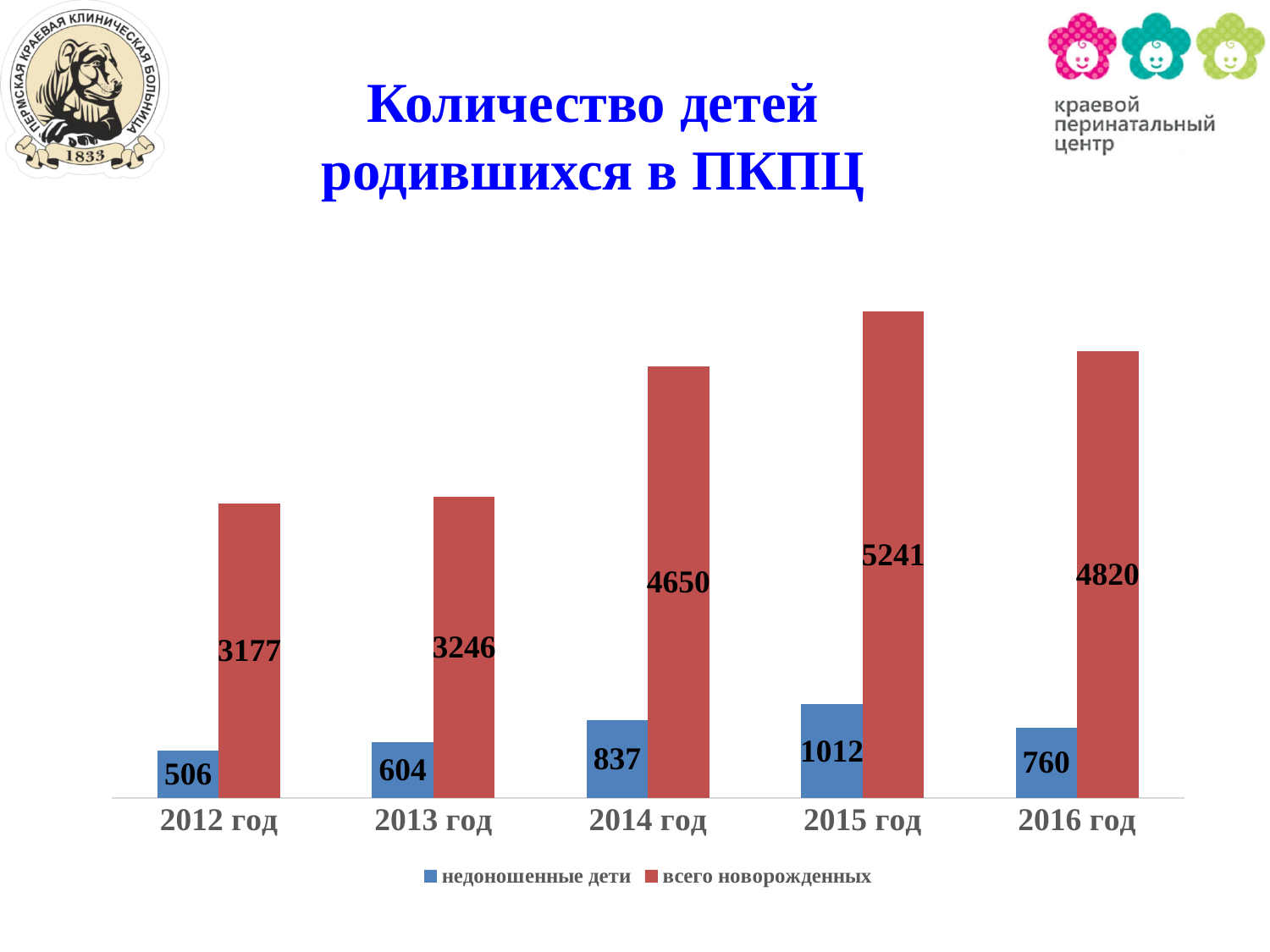
How many series does the legend list? 2 What is the title of the chart? Количество детей родившихся в ПКПЦ What is the value for всего новорожденных in 2014 год? 4650 What is the value for недоношенные дети in 2012 год? 506 What is the value for недоношенные дети in 2016 год? 760 Which year has the lowest value for недоношенные дети? 2012 год How many years are shown on the x axis? 5 What is the difference between недоношенные дети in 2015 год and 2014 год? 175 What is the difference between всего новорожденных in 2015 год and 2016 год? 421 Which year has the highest value for всего новорожденных? 2015 год Which is larger: всего новорожденных in 2012 год or in 2013 год? 2013 год What kind of chart is shown on the slide? bar chart